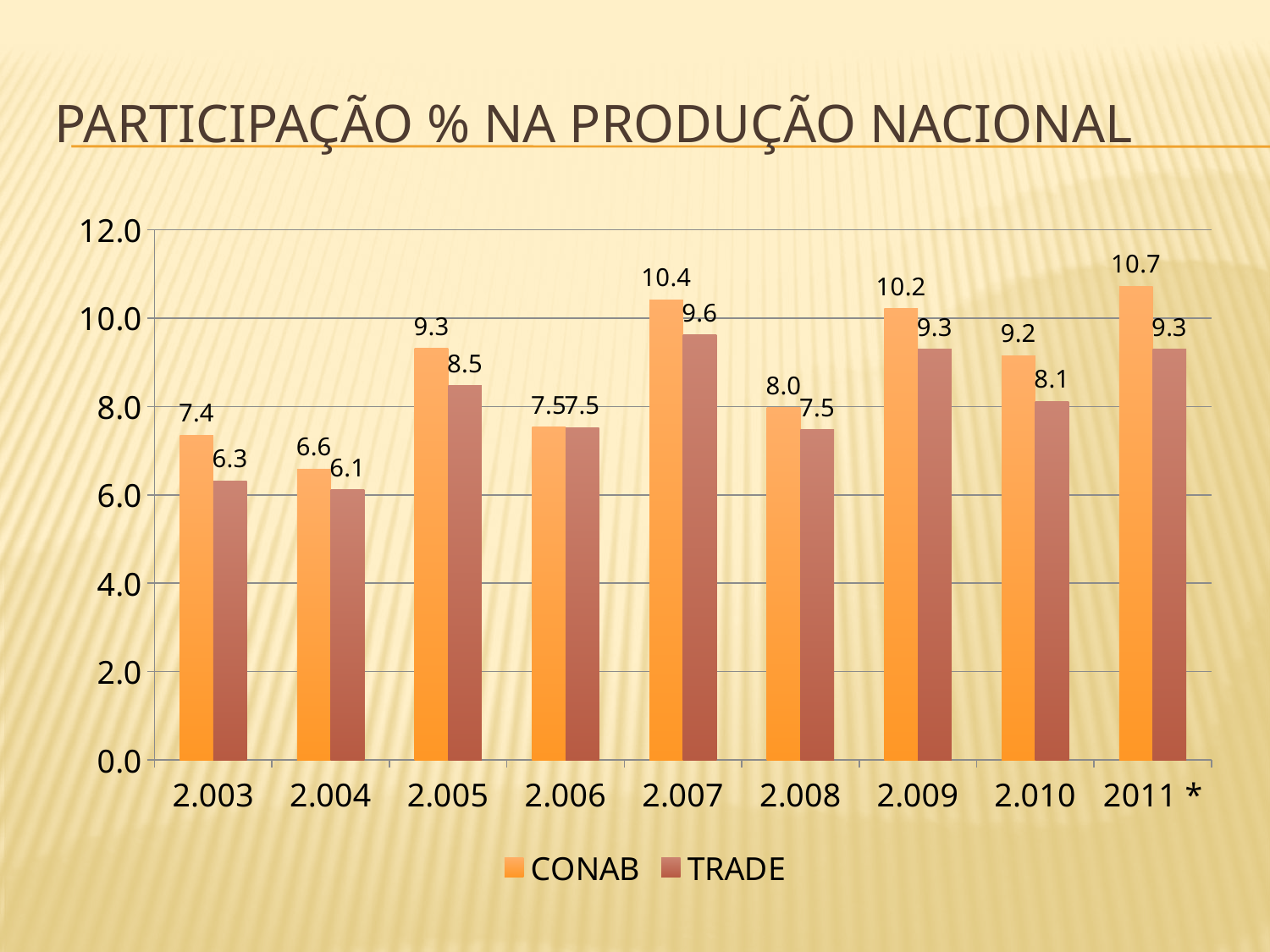
Which year has the highest CONAB value? 2011 * Is the TRADE value for 2.007 greater or less than 8.0? greater What kind of chart is shown on the slide? bar chart How many years are shown on the x axis? 9 How many series does the legend list? 2 Which is larger for 2.009, the CONAB value or the TRADE value? CONAB What is the title of the chart? PARTICIPAÇÃO % NA PRODUÇÃO NACIONAL What is the TRADE value for 2.005? 8.5 What is the difference between the CONAB and TRADE values for 2.003? 1.1 What is the CONAB value for 2011 *? 10.7 Which year has the lowest TRADE value? 2.004 What is the CONAB value for 2.007? 10.4